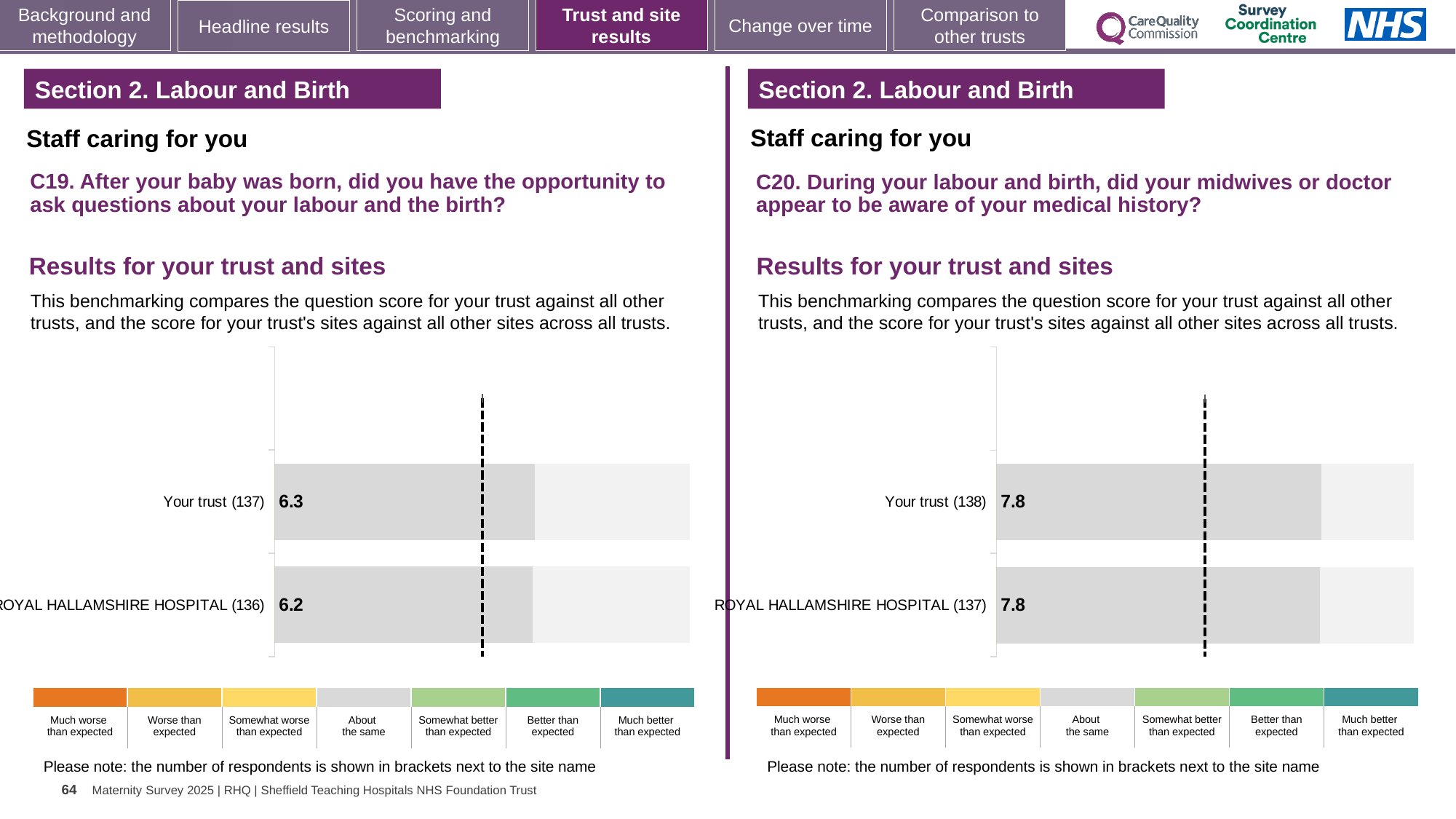
On the C19 chart on the left, what is the score for Your trust? 6.3 On the C19 chart on the left, which has the higher score, Your trust or Royal Hallamshire Hospital? Your trust What kind of chart is the C19 chart on the left? Bar chart On the C20 chart on the right, how many categories does the colour key below the chart list? 7 On the C19 chart on the left, what is the difference between the Your trust score and the Royal Hallamshire Hospital score? 0.1 On the C19 chart on the left, which benchmark category does the grey colour of the bars correspond to in the key? About the same On the C20 chart on the right, how many respondents are shown in brackets for Royal Hallamshire Hospital? 137 On the C20 chart on the right, how many bars are plotted? 2 On the C19 chart on the left, how many respondents are shown in brackets for Your trust? 137 On the C20 chart on the right, what is the score for Royal Hallamshire Hospital? 7.8 On the C20 chart on the right, what is the score for Your trust? 7.8 On the C19 chart on the left, what is the score for Royal Hallamshire Hospital? 6.2